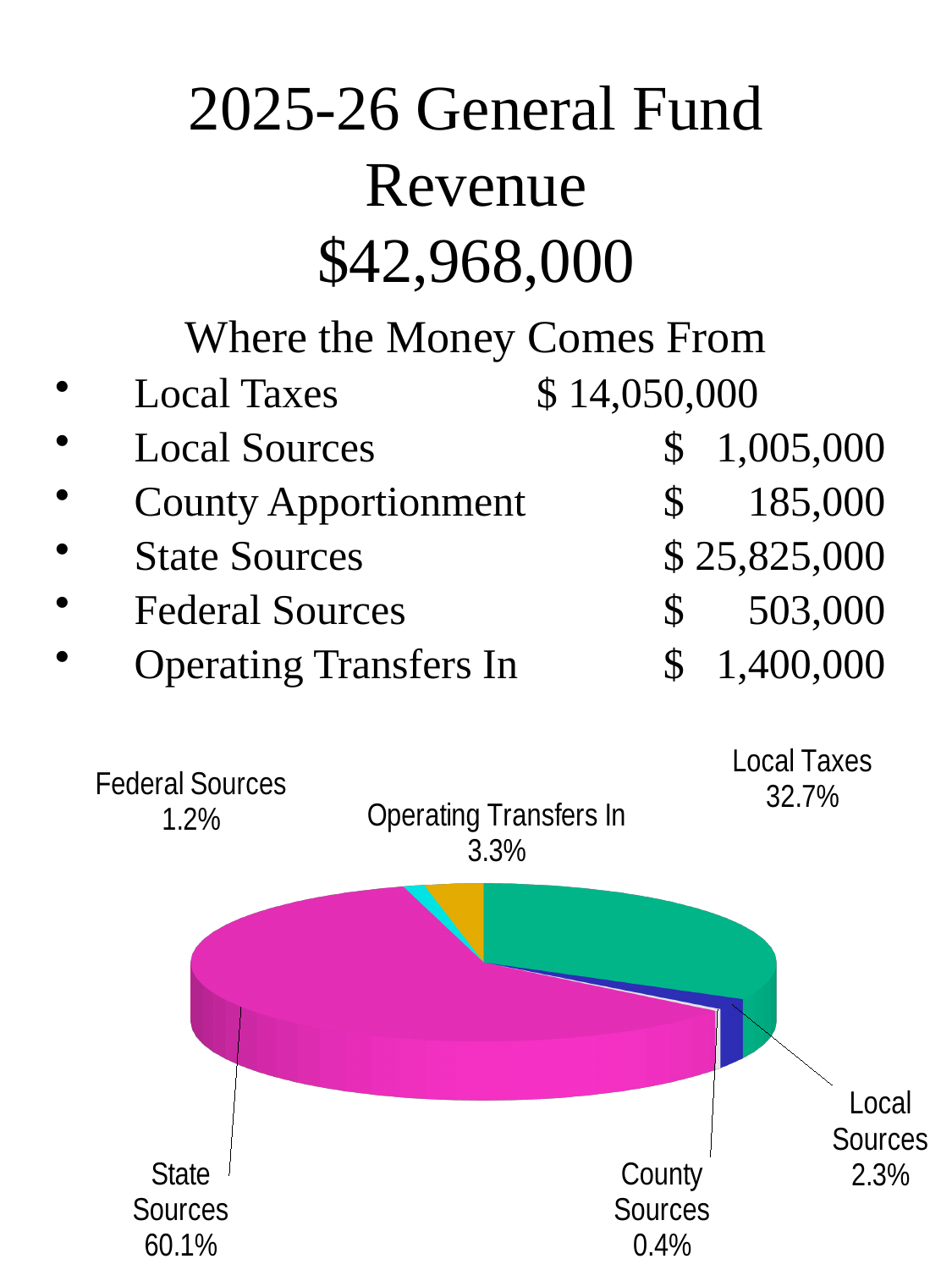
What percentage is shown for Operating Transfers In in the pie chart? 3.3% Which slice of the pie chart is the largest? State Sources What percentage is shown for Local Taxes in the pie chart? 32.7% What share of the pie does State Sources represent? 60.1% What kind of chart is shown on the slide? pie chart What percentage is shown for Federal Sources in the pie chart? 1.2% What percentage is shown for County Sources in the pie chart? 0.4% How many slices does the pie chart have? 6 Which is larger in the pie chart, Local Sources or Operating Transfers In? Operating Transfers In Which slice of the pie chart is the smallest? County Sources What is the difference in percentage points between State Sources and Local Taxes in the pie chart? 27.4 What colour is the State Sources slice in the pie chart? magenta